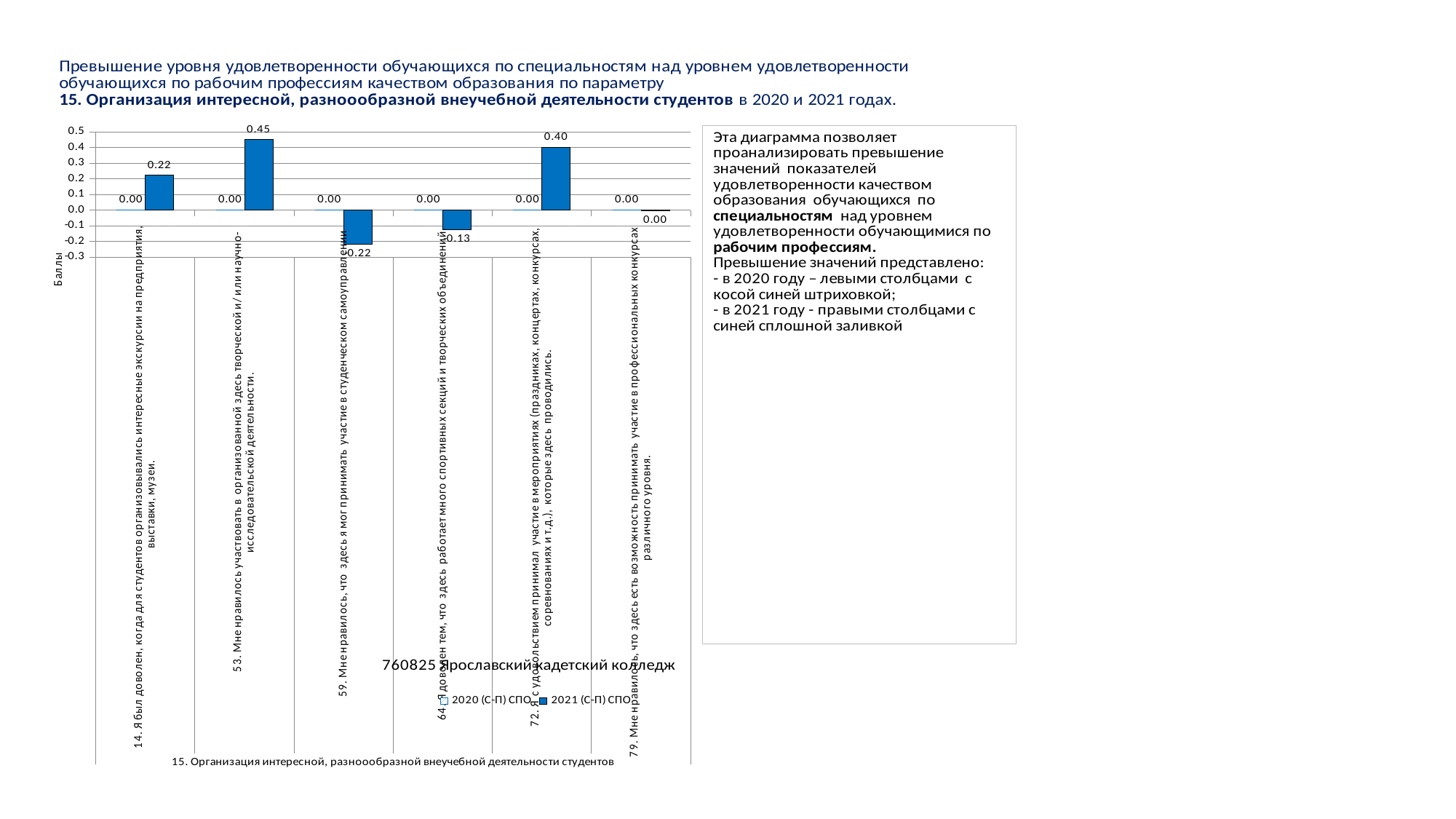
Which statement has the lowest 2021 (С-П) СПО value? 59. Мне нравилось, что здесь я мог принимать участие в студенческом самоуправлении What is the 2021 (С-П) СПО value for statement 14 ("Я был доволен, когда для студентов организовывались интересные экскурсии на предприятия, выставки, музеи")? 0.22 What is the difference between the 2021 (С-П) СПО values for statement 53 and statement 72? 0.05 What is the 2021 (С-П) СПО value for statement 59 ("Мне нравилось, что здесь я мог принимать участие в студенческом самоуправлении")? -0.22 What is the 2021 (С-П) СПО value for statement 53 ("Мне нравилось участвовать в организованной здесь творческой и/или научно-исследовательской деятельности")? 0.45 What is the 2021 (С-П) СПО value for statement 64 ("Я доволен тем, что здесь работает много спортивных секций и творческих объединений")? -0.13 How many series does the chart legend list? 2 Which statement has the highest 2021 (С-П) СПО value? 53. Мне нравилось участвовать в организованной здесь творческой и/или научно-исследовательской деятельности What type of chart is shown on the slide? bar chart Which is larger: the 2021 (С-П) СПО value for statement 14 or for statement 72? statement 72 What is the 2020 (С-П) СПО value for statement 72 ("Я с удовольствием принимал участие в мероприятиях...")? 0.00 How many categories (statements) are plotted on the x axis of the chart? 6